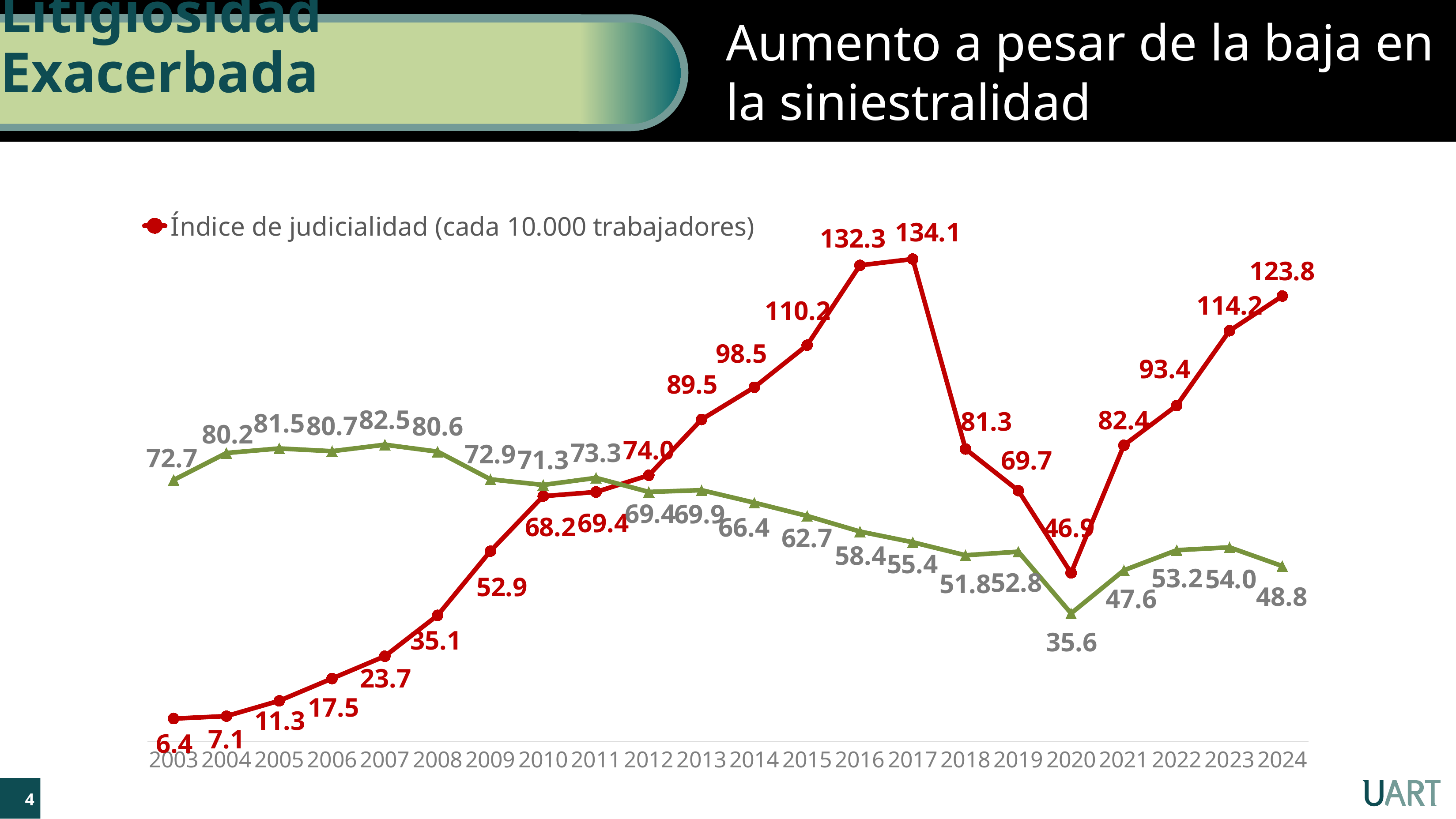
How many years are shown on the x axis of the chart? 22 By how much did the Índice de judicialidad fall from 2017 to 2018? 52.8 What is the difference between the Índice de judicialidad values for 2024 and 2020? 76.9 What is the value of the Índice de judicialidad (cada 10.000 trabajadores) in 2020? 46.9 In which year is the Índice de judicialidad (cada 10.000 trabajadores) lowest? 2003 How many series does the chart's legend list? 1 In which year is the Índice de judicialidad (cada 10.000 trabajadores) highest? 2017 What is the value of the Índice de judicialidad (cada 10.000 trabajadores) in 2024? 123.8 Which year has a higher Índice de judicialidad, 2016 or 2023? 2016 Does the Índice de judicialidad rise or fall from 2003 to 2017? Rise What is the value of the Índice de judicialidad (cada 10.000 trabajadores) in 2017? 134.1 What kind of chart is shown on the slide? Line chart